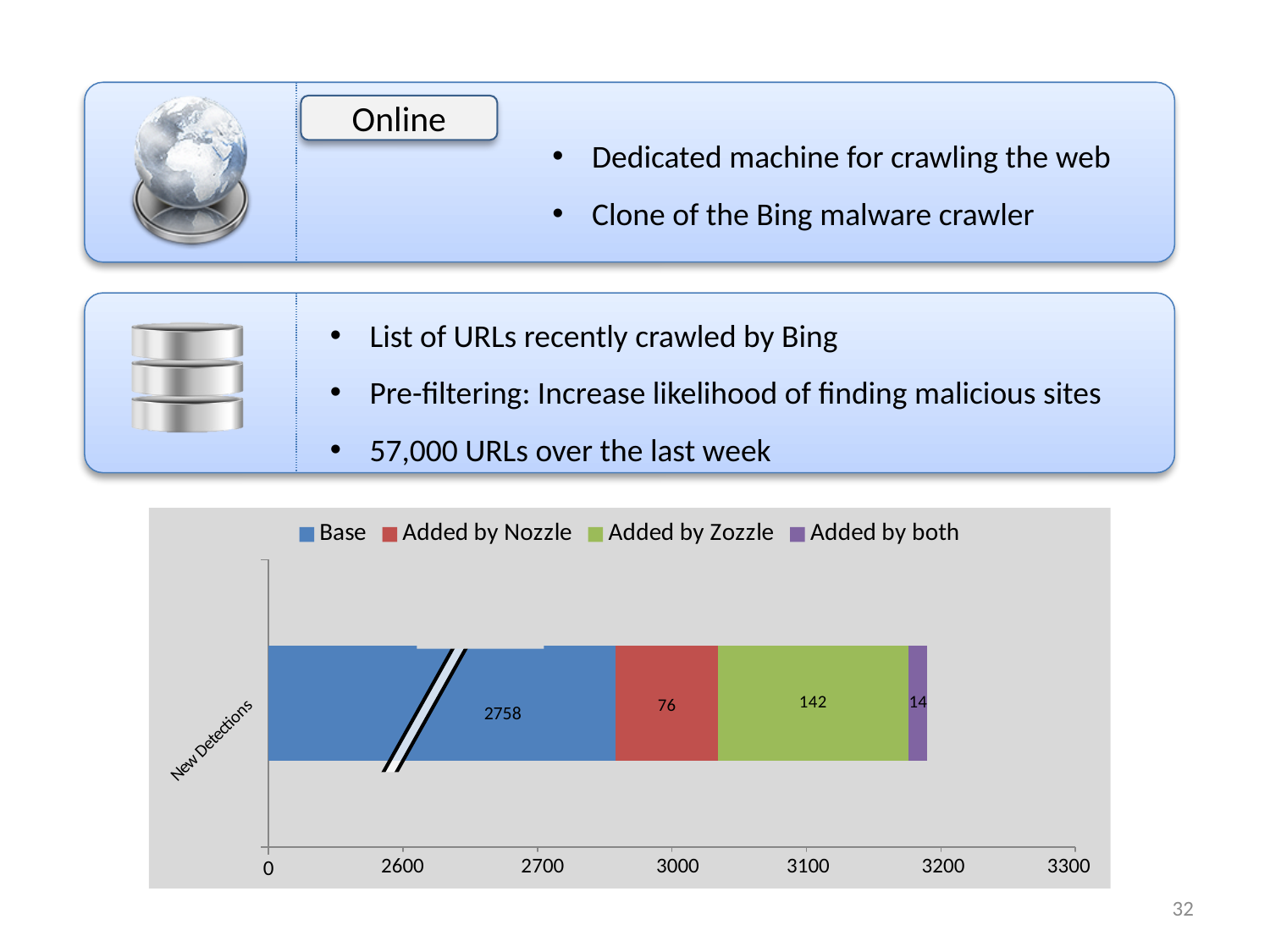
What is the label of the single category on the chart's vertical axis? New Detections What kind of chart is shown on the slide? Stacked bar chart Which is larger, the Added by Nozzle value or the Added by Zozzle value? Added by Zozzle What is the difference between the Added by Zozzle value and the Added by Nozzle value? 66 Which series has the largest value in the New Detections bar? Base Which series has the smallest value in the New Detections bar? Added by both What is the value of the Added by Nozzle series for New Detections? 76 What is the value of the Base series for New Detections? 2758 What is the value of the Added by both series for New Detections? 14 What is the total of the stacked New Detections bar? 2990 What is the value of the Added by Zozzle series for New Detections? 142 How many series does the legend list? 4